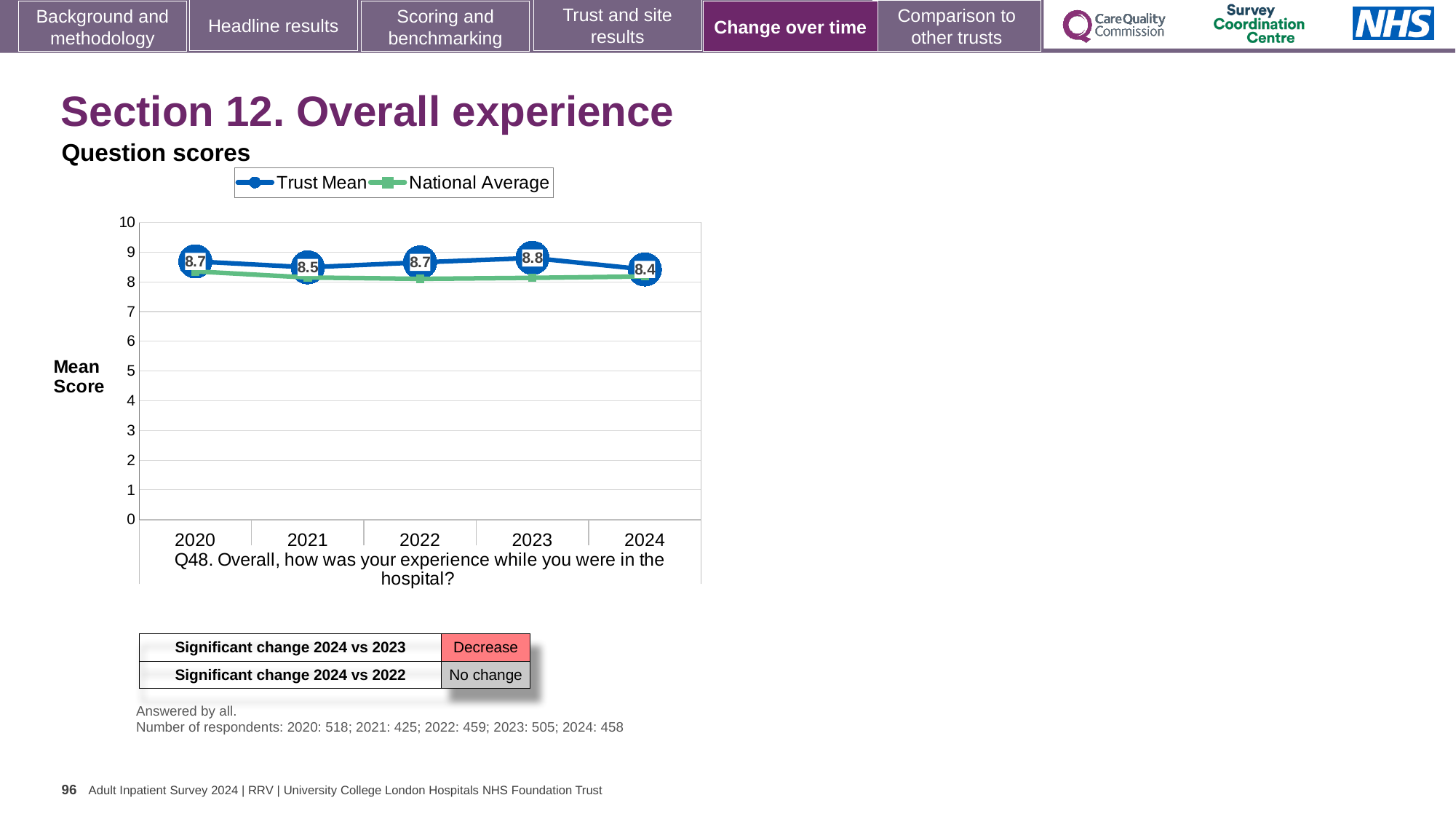
Which is larger, the Trust Mean score for 2020 or for 2021? 2020 What is the label of the y axis of the chart? Mean Score In which year is the Trust Mean score highest? 2023 Is the National Average value for 2022 greater or less than 9? less What is the Trust Mean score for 2023? 8.8 How many series does the chart legend list? 2 What is the Trust Mean score for 2024? 8.4 What is the difference between the Trust Mean scores for 2023 and 2024? 0.4 What kind of chart is shown on the slide? line chart How many years are shown on the x axis of the chart? 5 In which year is the Trust Mean score lowest? 2024 What is the Trust Mean score for 2021? 8.5